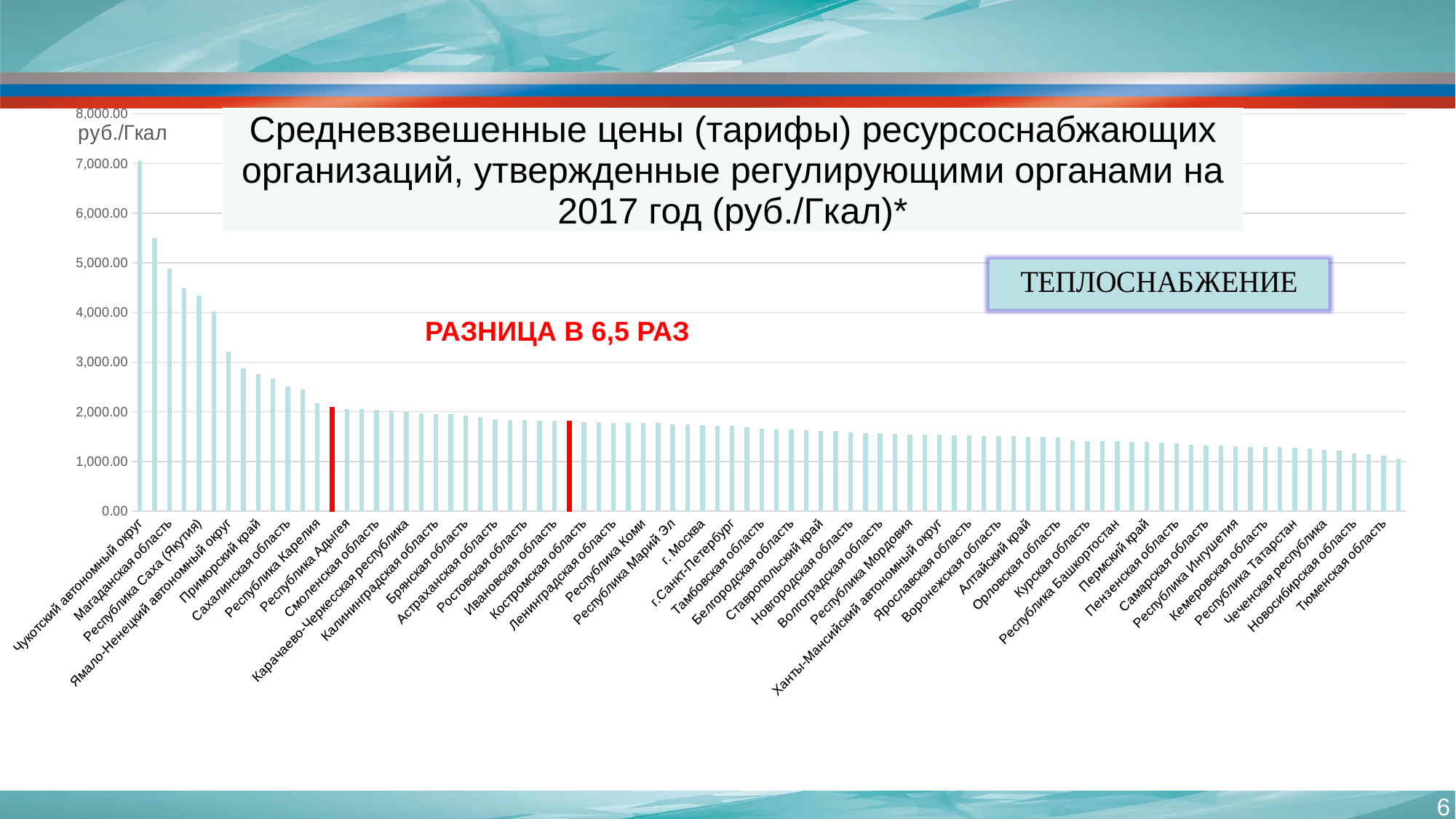
Is the value for Республика Саха (Якутия) greater or less than 3,000.00? greater Which region has the highest tariff in the chart? Чукотский автономный округ Which has the larger value, Чукотский автономный округ or Тюменская область? Чукотский автономный округ Is the value for Тюменская область greater or less than 2,000.00? less Is the value for Магаданская область greater or less than 4,000.00? greater What kind of chart is shown on the slide? bar chart Do the bar values rise or fall from left to right along the x axis? fall What does the red annotation on the chart say? РАЗНИЦА В 6,5 РАЗ What unit is shown on the vertical axis of the chart? руб./Гкал Which has the larger value, Магаданская область or г. Москва? Магаданская область